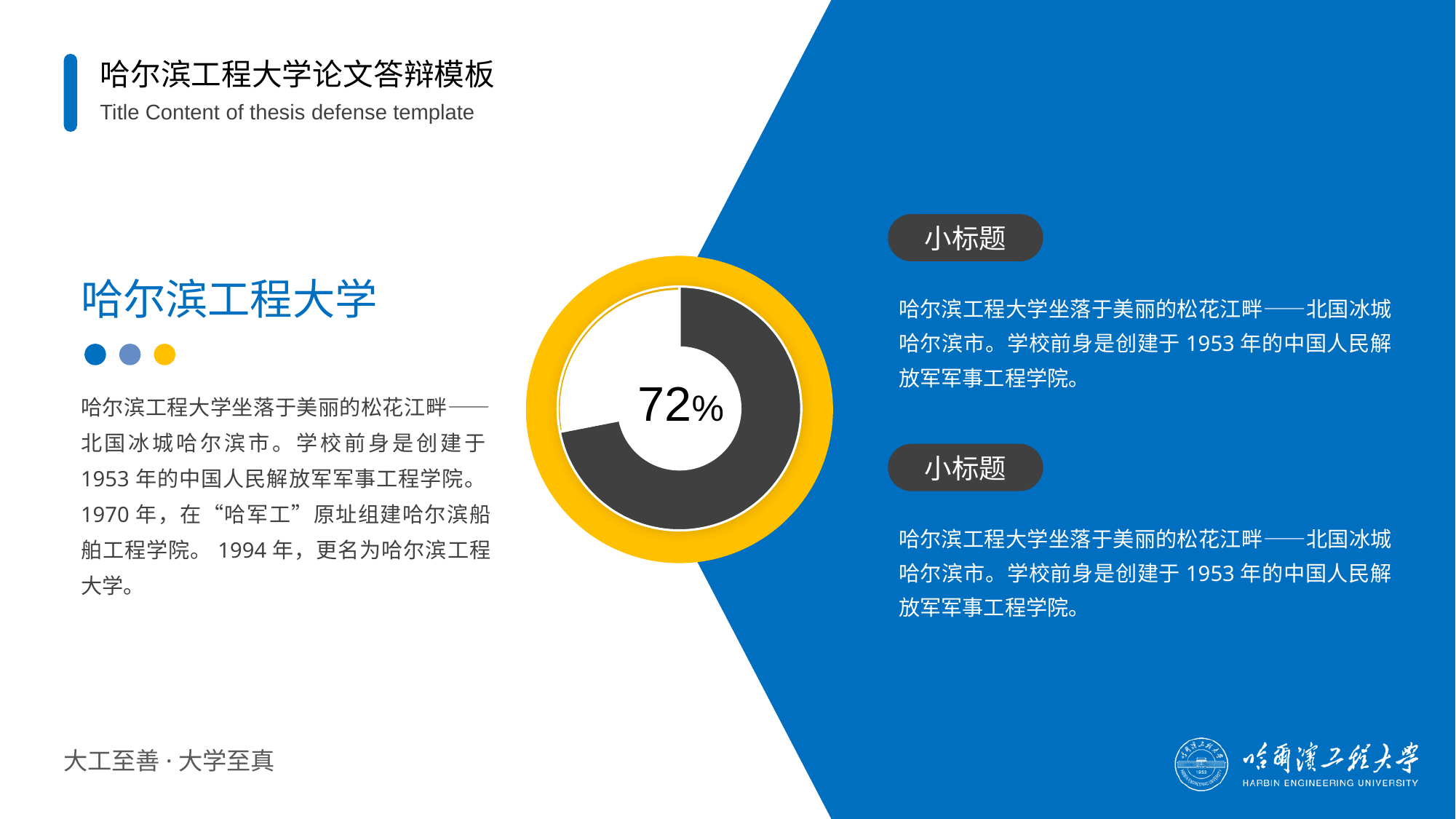
What colour is the larger segment of the doughnut chart? dark grey What colour is the ring surrounding the doughnut chart? yellow Is the dark grey segment of the doughnut chart larger or smaller than the white segment? larger Is the value shown in the doughnut chart greater or less than 50%? greater What percentage is printed in the centre of the doughnut chart? 72% What kind of chart is shown in the centre of the slide? doughnut chart What share of the doughnut chart does the dark grey segment represent? 72% How many segments does the doughnut chart have? 2 What share of the doughnut chart is left uncovered by the dark grey segment? 28%